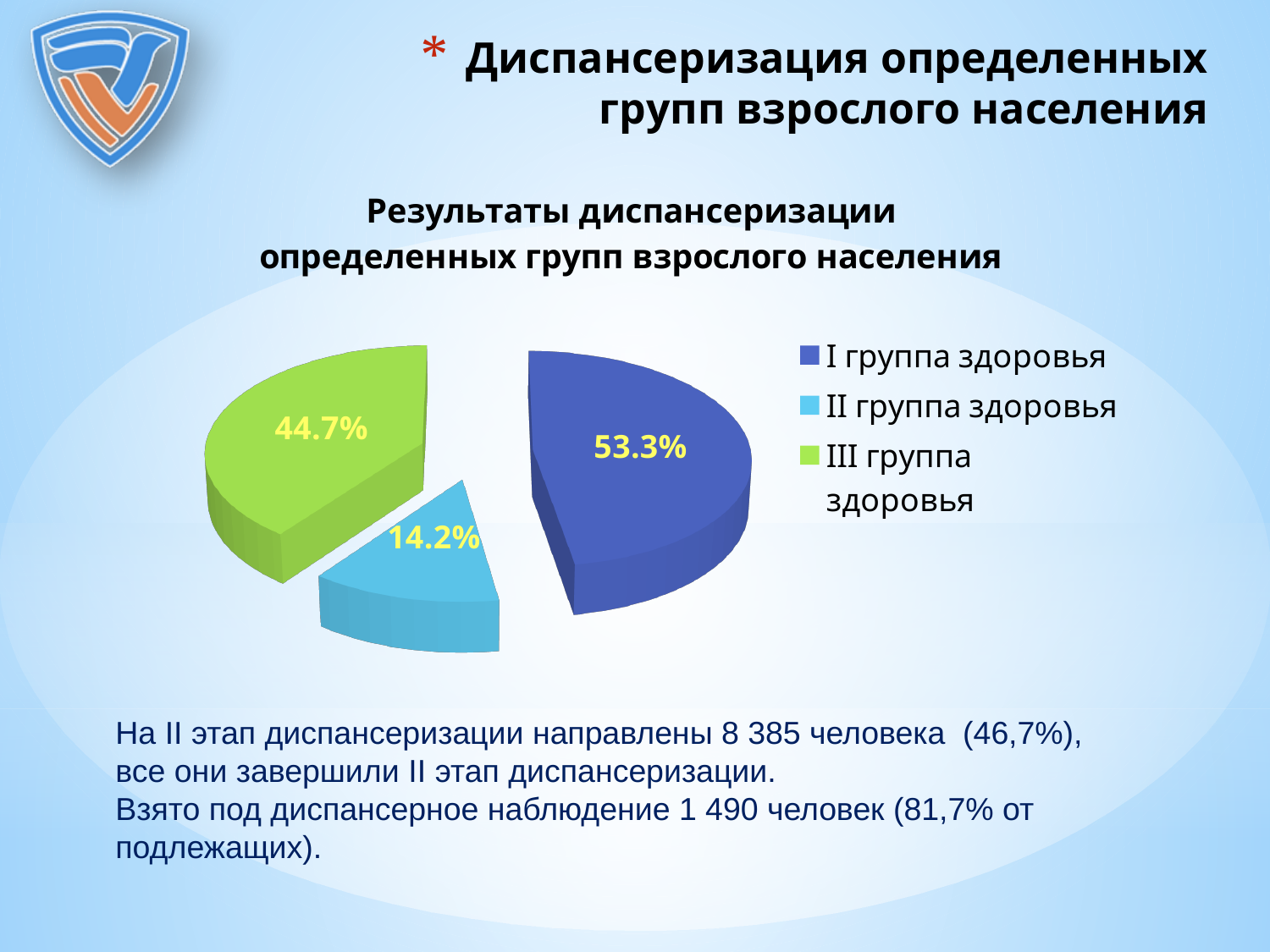
Which health group has the smallest slice of the pie? II группа здоровья Which is larger, the value for II группа здоровья or the value for III группа здоровья? III группа здоровья What is the value shown for II группа здоровья? 14.2% What kind of chart is shown on the slide? Pie chart How many slices does the pie chart have? 3 What is the difference between the values for III группа здоровья and II группа здоровья? 30.5% What is the difference between the values for I группа здоровья and III группа здоровья? 8.6% How many entries does the legend list? 3 What is the value shown for I группа здоровья? 53.3% Which health group has the largest slice of the pie? I группа здоровья What colour is the slice for III группа здоровья? Green What is the value shown for III группа здоровья? 44.7%